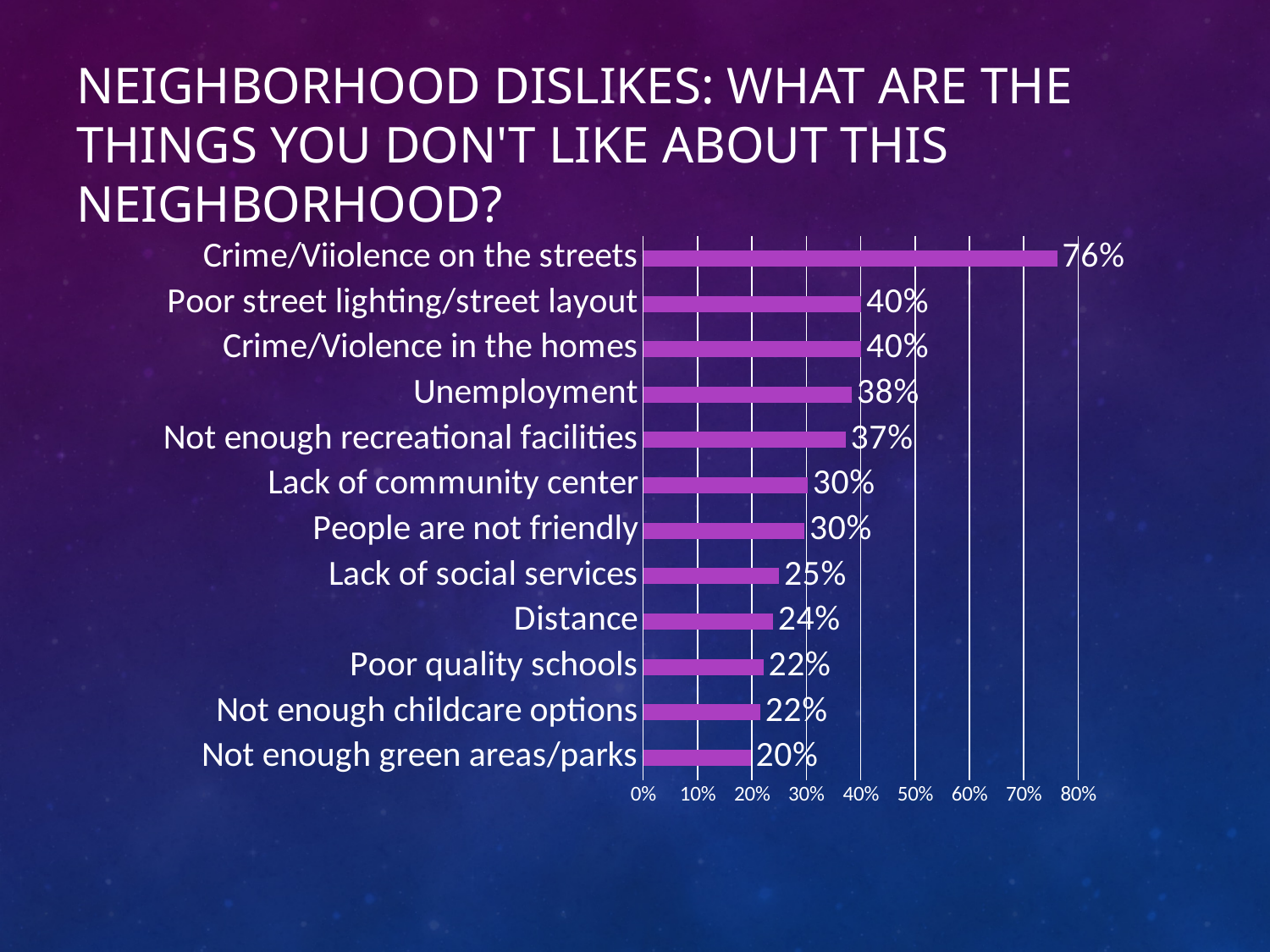
What is the highest value shown on the percentage axis? 80% What is the value for Not enough recreational facilities? 37% What kind of chart is shown on the slide? Bar chart Which neighborhood dislike has the lowest percentage? Not enough green areas/parks Which is larger, the value for Unemployment or the value for Lack of community center? Unemployment What is the value for Lack of social services? 25% What is the value for Unemployment? 38% Which neighborhood dislike has the highest percentage? Crime/Viiolence on the streets What percentage of respondents cited Crime/Viiolence on the streets as a neighborhood dislike? 76% How many categories are shown in the chart? 12 What is the difference between the value for Distance and the value for Not enough green areas/parks? 4% What is the difference between the value for Crime/Viiolence on the streets and the value for Poor street lighting/street layout? 36%